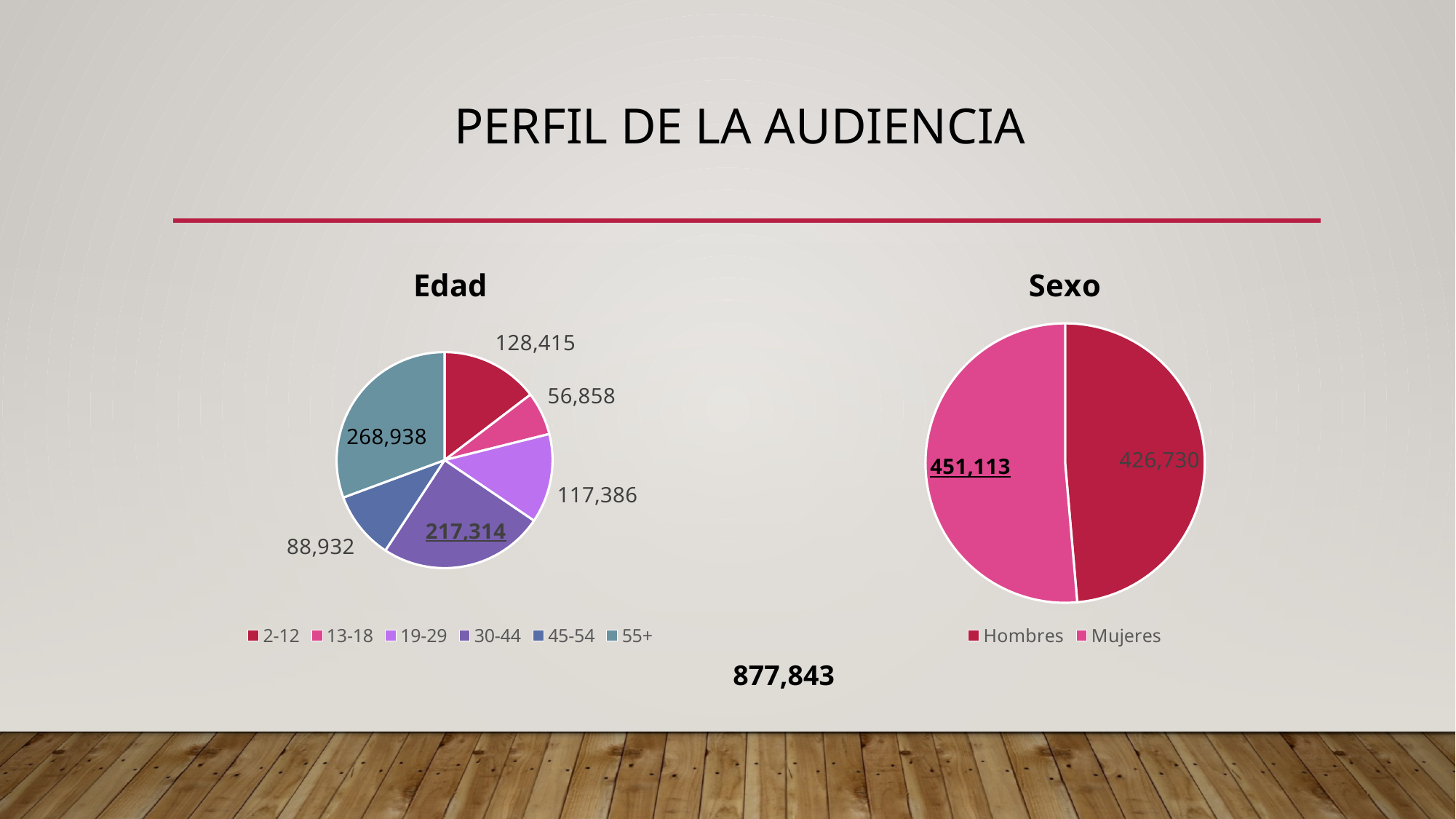
In the Edad chart, what is the value for the 30-44 age group? 217,314 In the Edad chart, which age group has the smallest value? 13-18 How many age groups does the Edad chart show? 6 In the Edad chart, which is larger, the 2-12 group or the 19-29 group? 2-12 In the Sexo chart, what is the value for Mujeres? 451,113 In the Edad chart, what is the value for the 13-18 age group? 56,858 In the Sexo chart, what is the difference between Mujeres and Hombres? 24,383 In the Edad chart, what is the difference between the 55+ and 30-44 groups? 51,624 What is the total of all the slices in the Edad chart? 877,843 In the Edad chart, which age group has the largest value? 55+ In the Edad chart, what is the value for the 55+ age group? 268,938 What type of chart is the Sexo chart? Pie chart